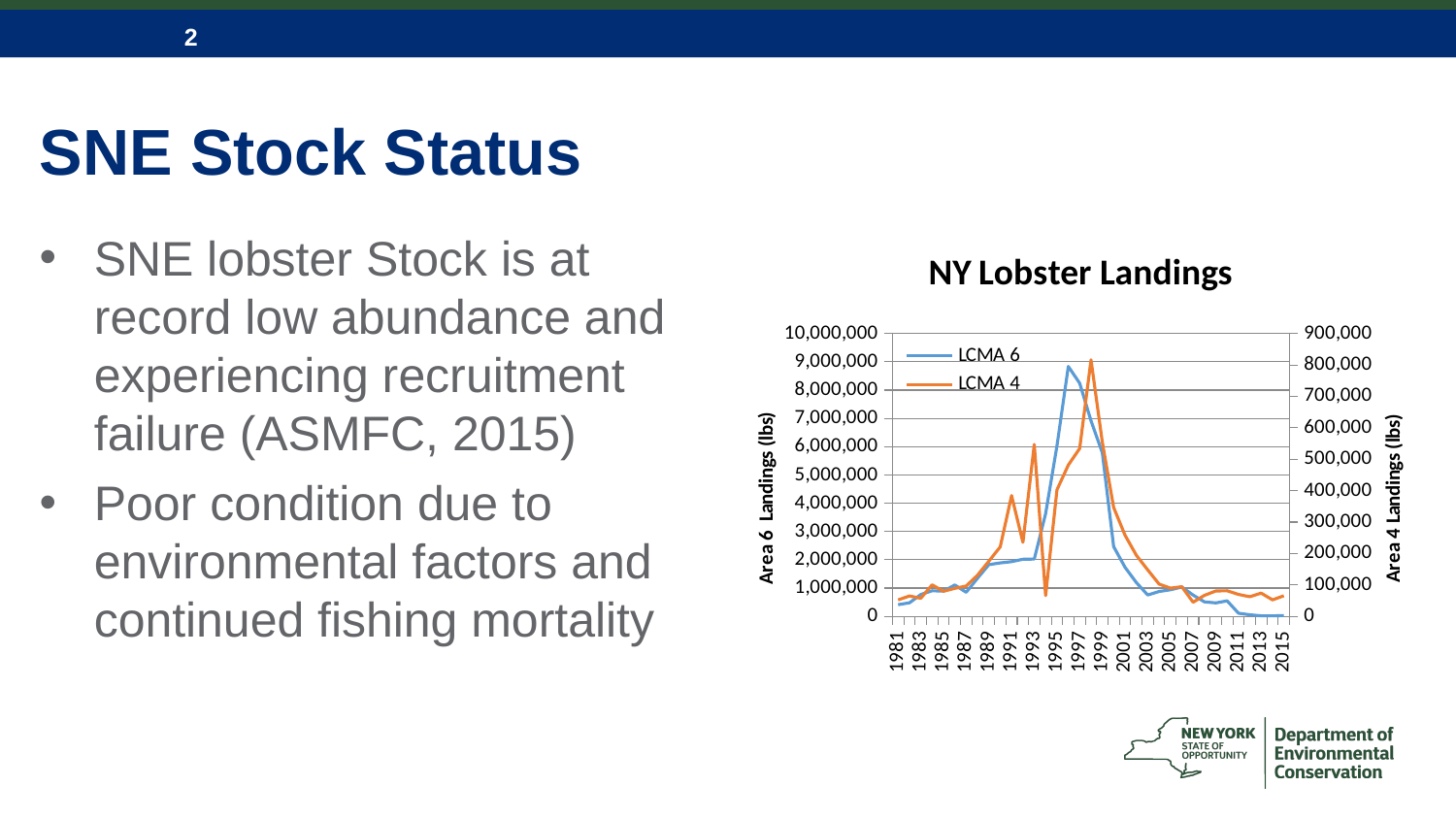
In which year does the LCMA 4 series reach its highest value? 1998 What is the title of the chart? NY Lobster Landings Is the LCMA 6 value in 2015 greater or less than 1,000,000 on the left axis? less Does the LCMA 6 series rise or fall from 1997 to 2015? fall Is the LCMA 6 value in 1981 greater or less than 1,000,000 on the left axis? less Is the peak value of the LCMA 4 series greater or less than 700,000 on the right axis? greater In which year does the LCMA 6 series reach its highest value? 1996 What kind of chart is shown on the slide? Line chart How many series does the legend of the chart list? 2 Which is larger for the LCMA 6 series: the value in 1997 or the value in 2015? 1997 What is the label of the left vertical axis of the chart? Area 6 Landings (lbs)